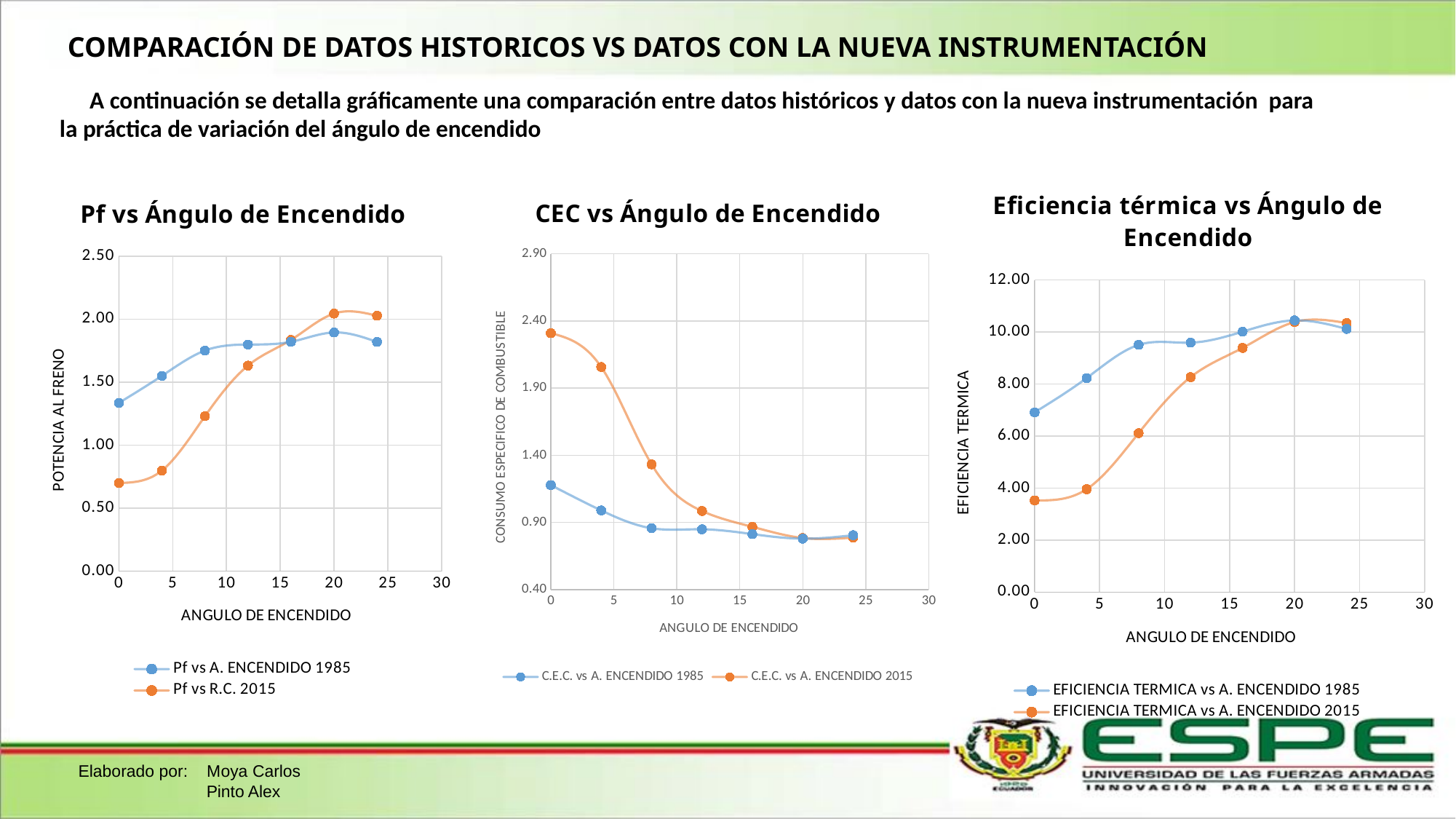
In the 'Eficiencia térmica vs Ángulo de Encendido' chart, is the value of 'EFICIENCIA TERMICA vs A. ENCENDIDO 2015' at angle 0 greater or less than 4.00? less What kind of chart is the 'Pf vs Ángulo de Encendido' chart? line chart How many series does the legend of the 'CEC vs Ángulo de Encendido' chart list? 2 In the 'CEC vs Ángulo de Encendido' chart, which series has the larger value at angle 4? C.E.C. vs A. ENCENDIDO 2015 In the 'Eficiencia térmica vs Ángulo de Encendido' chart, how many data points does the 'EFICIENCIA TERMICA vs A. ENCENDIDO 2015' series have? 7 In the 'Eficiencia térmica vs Ángulo de Encendido' chart, which series has the larger value at angle 8? EFICIENCIA TERMICA vs A. ENCENDIDO 1985 What is the y-axis label of the 'CEC vs Ángulo de Encendido' chart? CONSUMO ESPECIFICO DE COMBUSTIBLE In the 'Pf vs Ángulo de Encendido' chart, which series has the larger value at angle 0? Pf vs A. ENCENDIDO 1985 In the 'Pf vs Ángulo de Encendido' chart, is the value of 'Pf vs R.C. 2015' at angle 0 greater or less than 1.00? less In the 'Pf vs Ángulo de Encendido' chart, is the value of 'Pf vs R.C. 2015' at angle 20 greater or less than 2.00? greater In the 'CEC vs Ángulo de Encendido' chart, do the values of 'C.E.C. vs A. ENCENDIDO 2015' rise or fall as the angle increases? fall